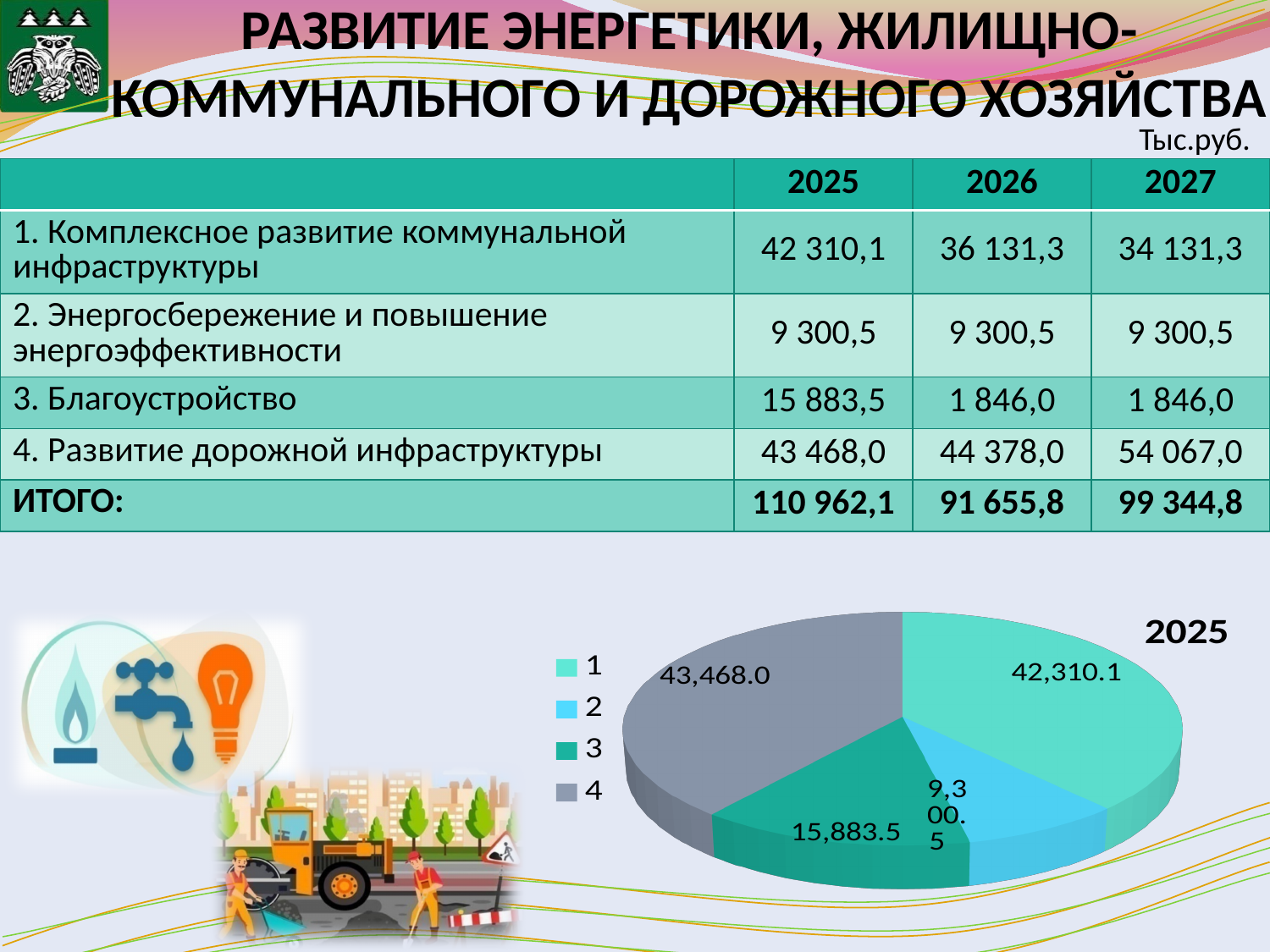
Which year is labelled next to the pie chart? 2025 Which category has the smallest slice in the pie chart? 2 Which category has the largest slice in the pie chart? 4 In the pie chart, what is the value of the slice for category 3? 15,883.5 How many slices does the pie chart have? 4 In the pie chart, what is the value of the slice for category 4? 43,468.0 What kind of chart is shown at the bottom of the slide? pie chart In the pie chart, what is the difference between the values for category 3 and category 2? 6,583.0 In the pie chart, what is the difference between the values for category 4 and category 1? 1,157.9 In the pie chart, which is larger: the value for category 1 or the value for category 3? category 1 In the pie chart, what is the value of the slice for category 1? 42,310.1 In the pie chart, what is the value of the slice for category 2? 9,300.5